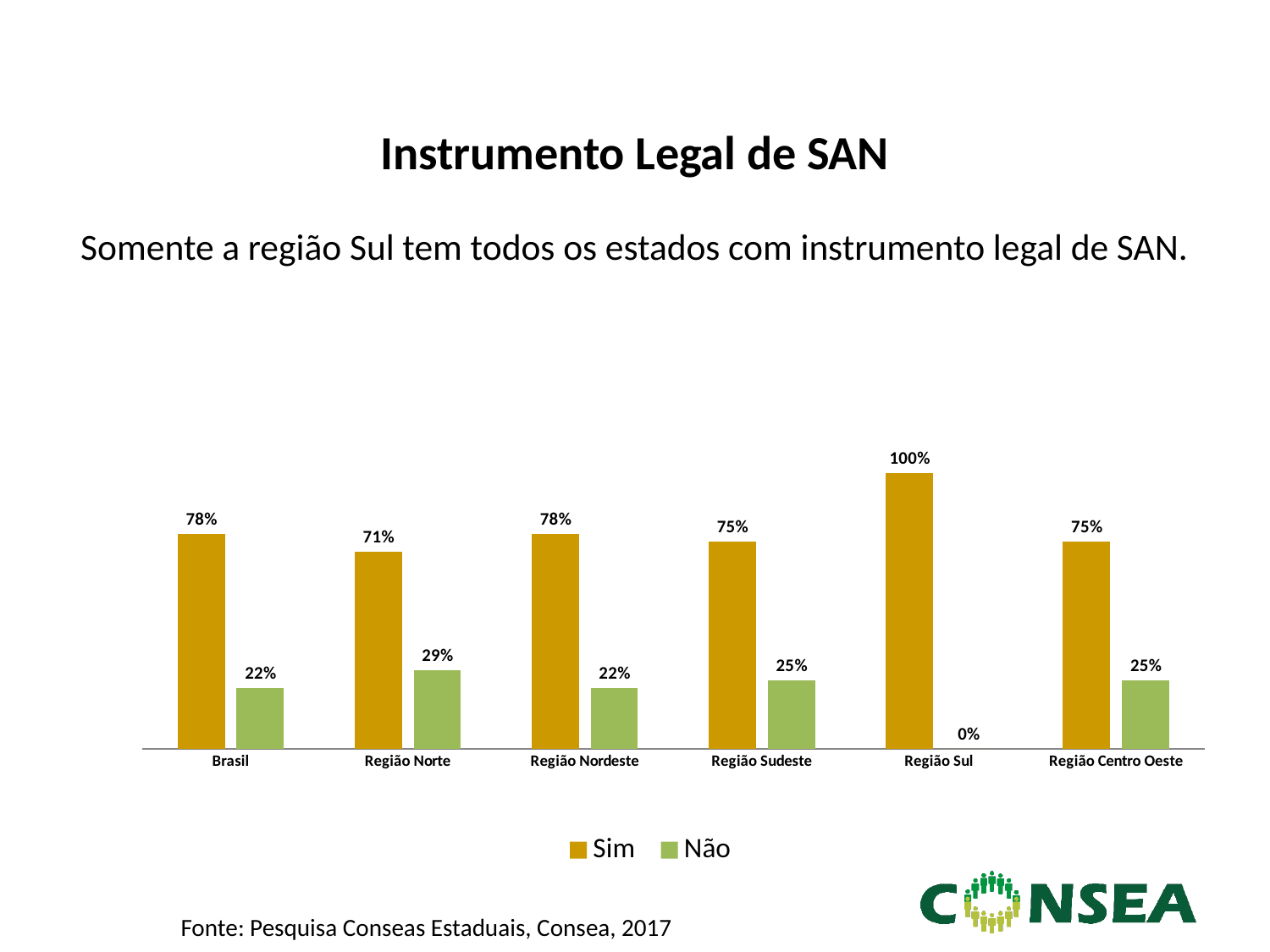
Which category has the lowest 'Sim' value? Região Norte How many categories are shown on the x axis? 6 Which category has the highest 'Sim' value? Região Sul What kind of chart is shown on the slide? Bar chart What are the two series named in the legend? Sim and Não What is the 'Não' value for Região Sul? 0% What is the difference between the 'Sim' values for Região Sul and Região Norte? 29% What is the 'Sim' value for Brasil? 78% What is the 'Sim' value for Região Sul? 100% How many series does the legend list? 2 What is the 'Não' value for Região Norte? 29% Which is larger: the 'Não' value for Região Norte or the 'Não' value for Região Nordeste? Região Norte